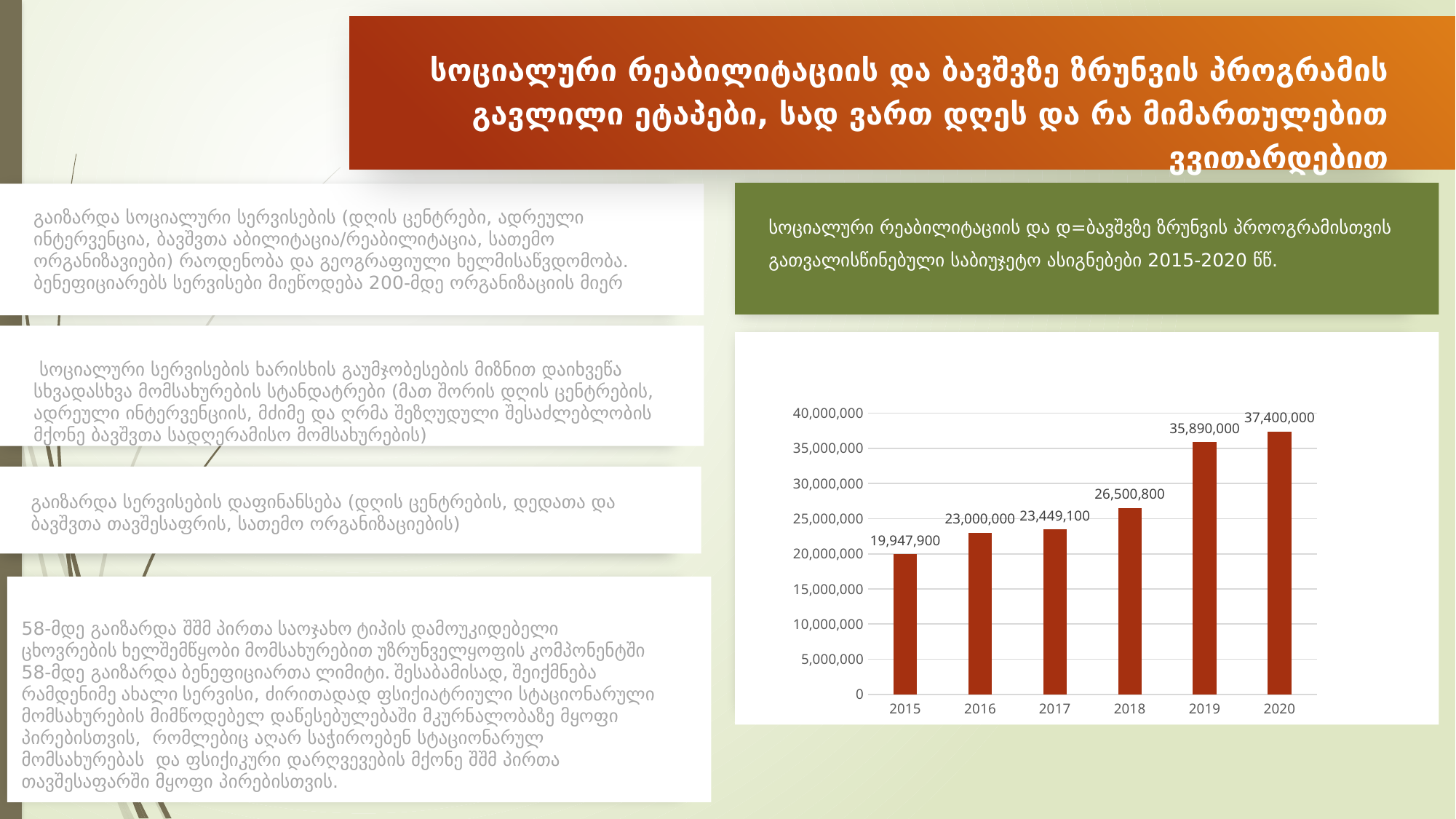
What is the value for 2020? 37,400,000 What kind of chart is shown? bar chart What is the difference between the values for 2020 and 2019? 1,510,000 Which year has the lowest value? 2015 What is the difference between the values for 2019 and 2018? 9,389,200 Is the value for 2019 greater or less than 30,000,000? greater Which year has the highest value? 2020 What is the value for 2018? 26,500,800 What is the value for 2015? 19,947,900 Which is larger, the value for 2016 or the value for 2018? 2018 How many years are shown on the x axis? 6 Do the values rise or fall from 2015 to 2020? rise